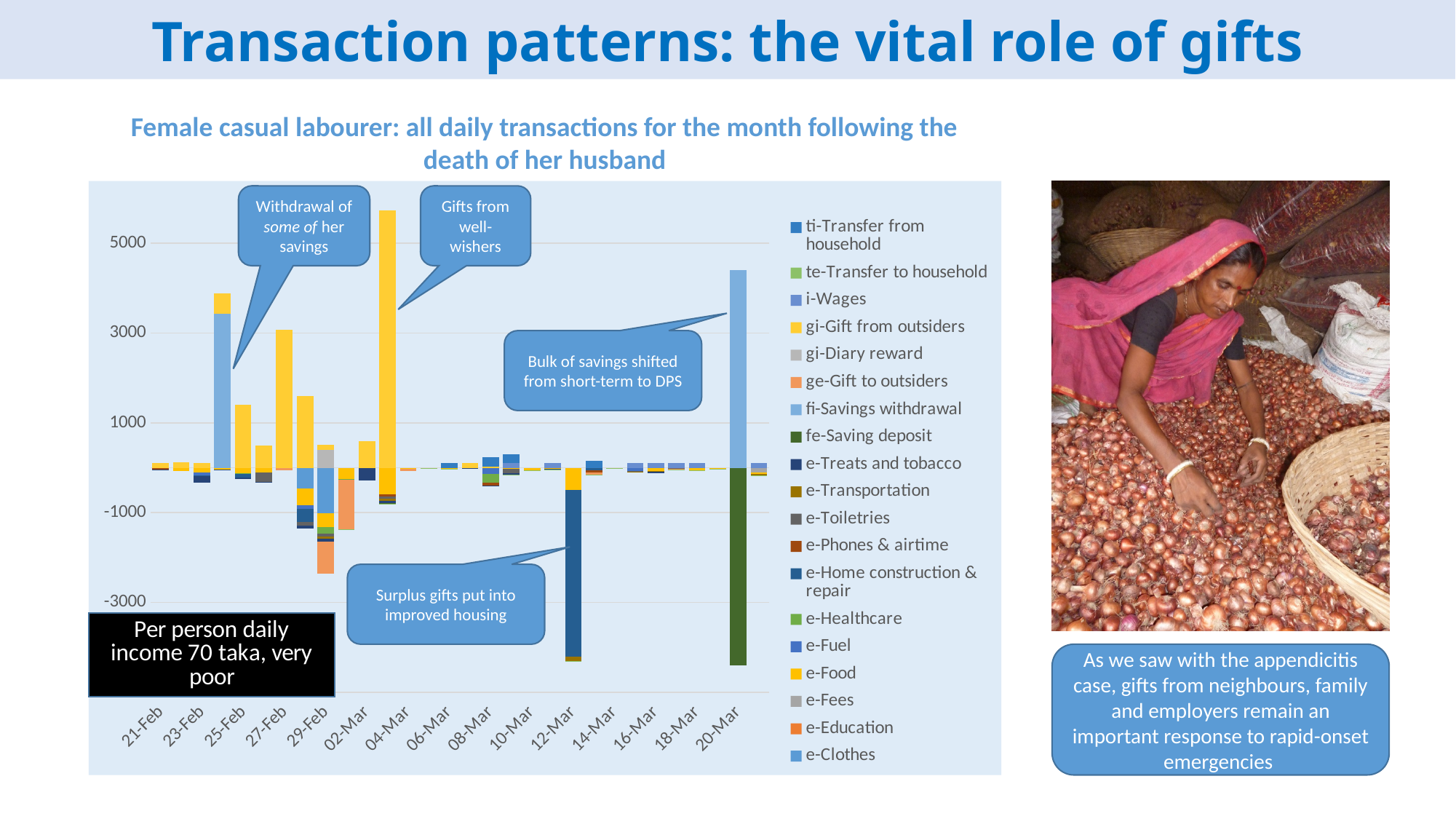
Is the negative (below zero) value for 12-Mar greater or less than -3000? less What is the title of the chart? Female casual labourer: all daily transactions for the month following the death of her husband What is the highest value shown on the y axis? 5000 Which series does the legend list first? ti-Transfer from household How many series does the chart's legend list? 19 What is the lowest value shown on the y axis? -3000 Is the positive (above zero) value for 20-Mar greater or less than 3000? greater What kind of chart is shown on the slide? bar chart Which is larger in magnitude: the negative bar for 12-Mar or the negative bar for 10-Mar? 12-Mar Is the negative (below zero) value for 20-Mar greater or less than -3000? less Which is larger: the positive bar for 20-Mar or the positive bar for 16-Mar? 20-Mar